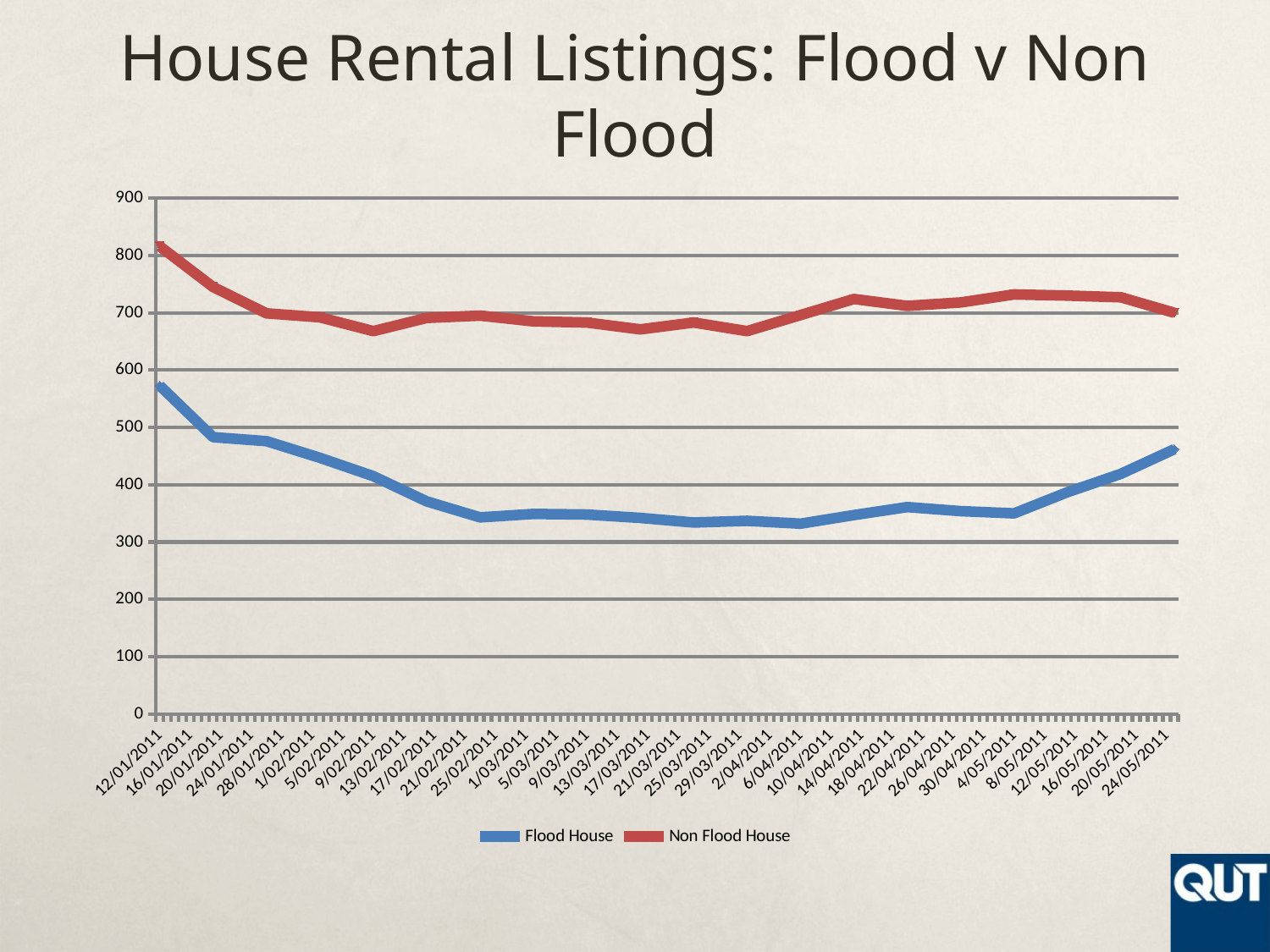
What are the two series named in the legend? Flood House and Non Flood House Is the value for Non Flood House on 12/01/2011 greater or less than 800? greater Does the Flood House series rise or fall between 12/01/2011 and 25/02/2011? fall Is the value for Flood House on 6/04/2011 greater or less than 400? less Is the value for Flood House on 24/05/2011 greater or less than 500? less How many series does the legend list? 2 What type of chart is shown on the slide? line chart What is the title of the chart? House Rental Listings: Flood v Non Flood Which series has the higher value on 12/01/2011, Flood House or Non Flood House? Non Flood House On which date does the Flood House series reach its highest value? 12/01/2011